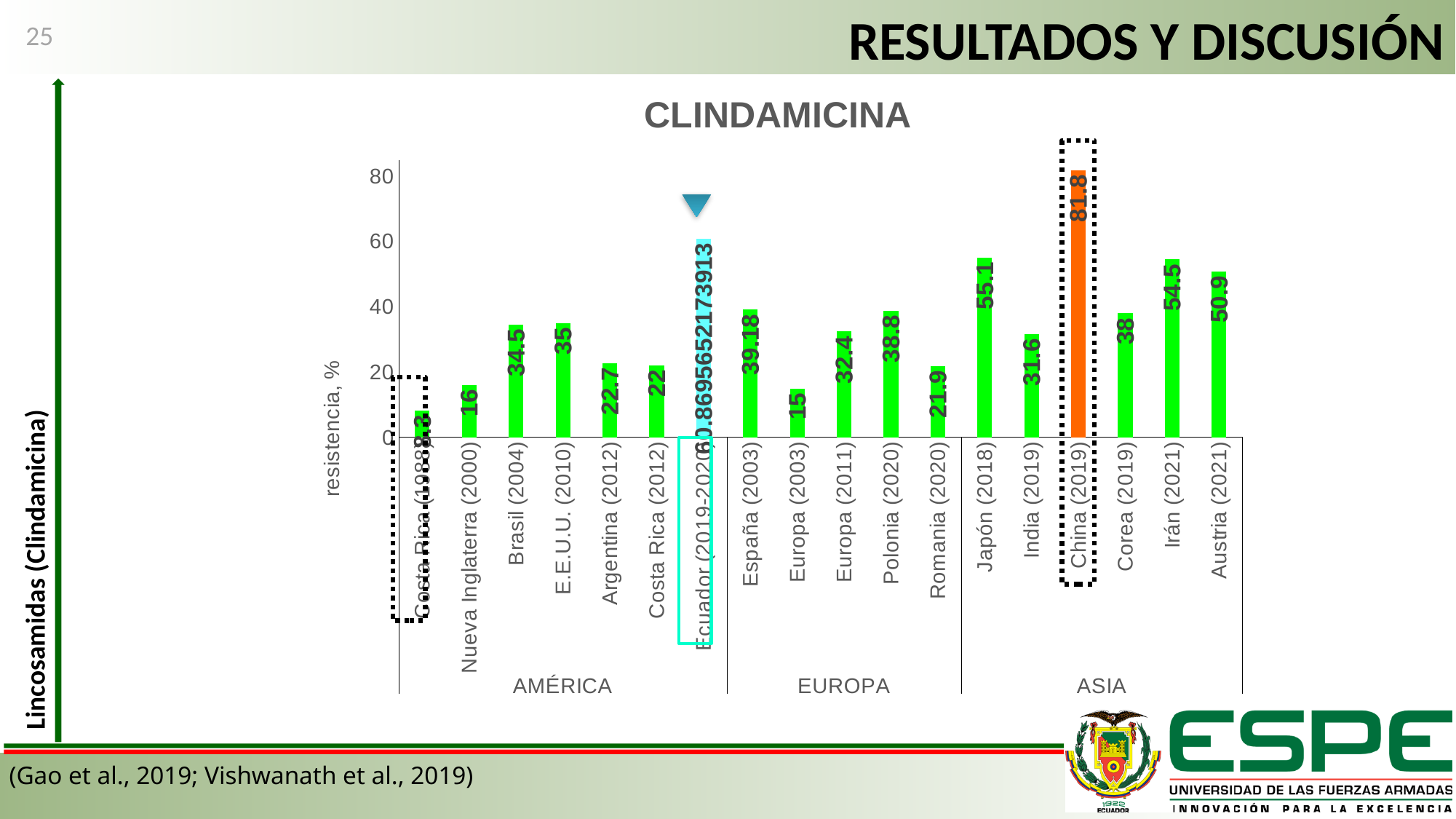
What is the resistance value for Polonia (2020)? 38.8 What is the label of the vertical axis? resistencia, % What is the difference between the values for Irán (2021) and Austria (2021)? 3.6 How many categories (bars) are plotted in the chart? 18 Which is larger, the value for España (2003) or the value for Europa (2011)? España (2003) What kind of chart is shown? bar chart Which category has the highest resistance value? China (2019) Is the value for Ecuador (2019-2020) greater or less than 40? greater What is the resistance value for Corea (2019)? 38 What is the resistance value for Japón (2018)? 55.1 What is the resistance value for China (2019)? 81.8 Within the EUROPA group, which category has the lowest resistance value? Europa (2003)